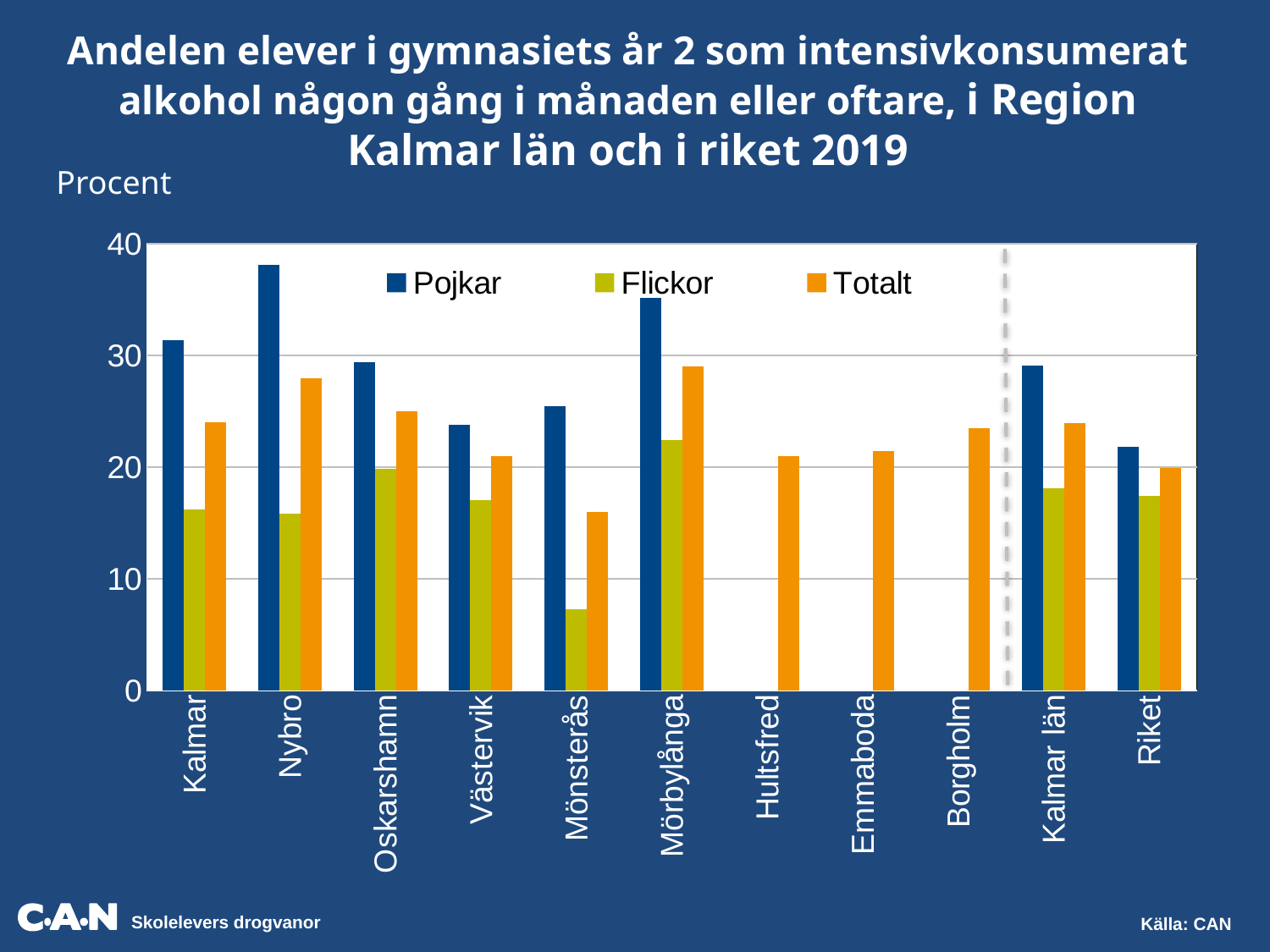
What kind of chart is shown on the slide? Bar chart How many categories are shown along the x axis? 11 Is the Totalt value for Mönsterås greater or less than 20? less Which is larger, the Totalt value for Nybro or the Totalt value for Västervik? Nybro What unit label is shown above the y axis? Procent Is the Pojkar value for Nybro greater or less than 30? greater How many series does the legend list? 3 Is the Flickor value for Mönsterås greater or less than 10? less Which category has the lowest value for Flickor? Mönsterås Which category has the lowest value for Totalt? Mönsterås Which category has the highest value for Pojkar? Nybro Which is larger, the Pojkar value for Kalmar or the Pojkar value for Västervik? Kalmar